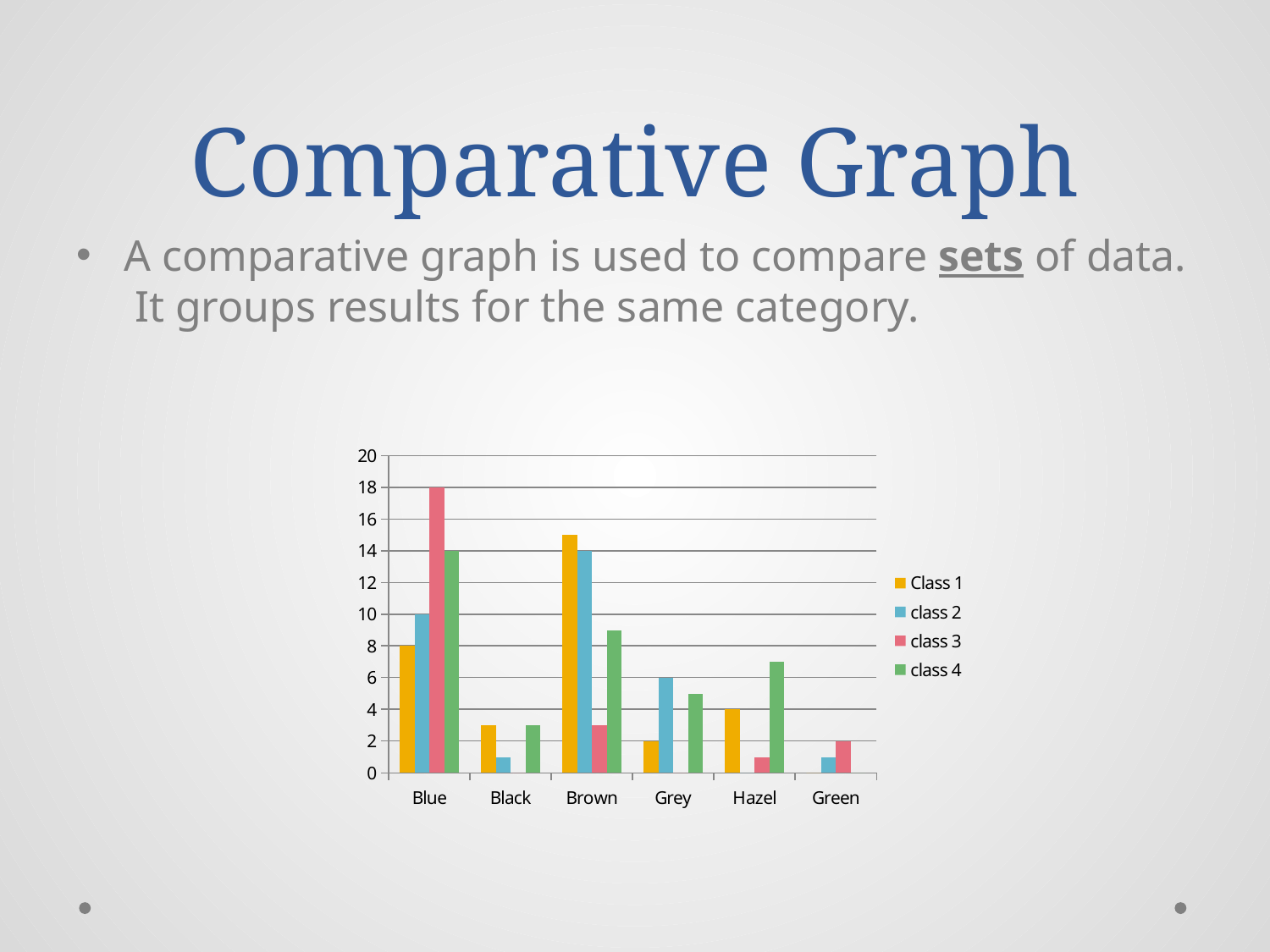
How many categories are shown on the x axis? 6 What is the value for class 2 in the Grey category? 6 How many series does the legend list? 4 Which category has the highest class 3 value? Blue What kind of chart is shown on the slide? bar chart What is the value for Class 1 in the Blue category? 8 What is the value for class 2 in the Blue category? 10 Is the value for Class 1 in the Brown category greater or less than 14? greater Which category has the lowest Class 1 value? Green What is the difference between the class 3 and Class 1 values in the Blue category? 10 Which is larger in the Hazel category, class 4 or Class 1? class 4 What is the value for class 3 in the Blue category? 18